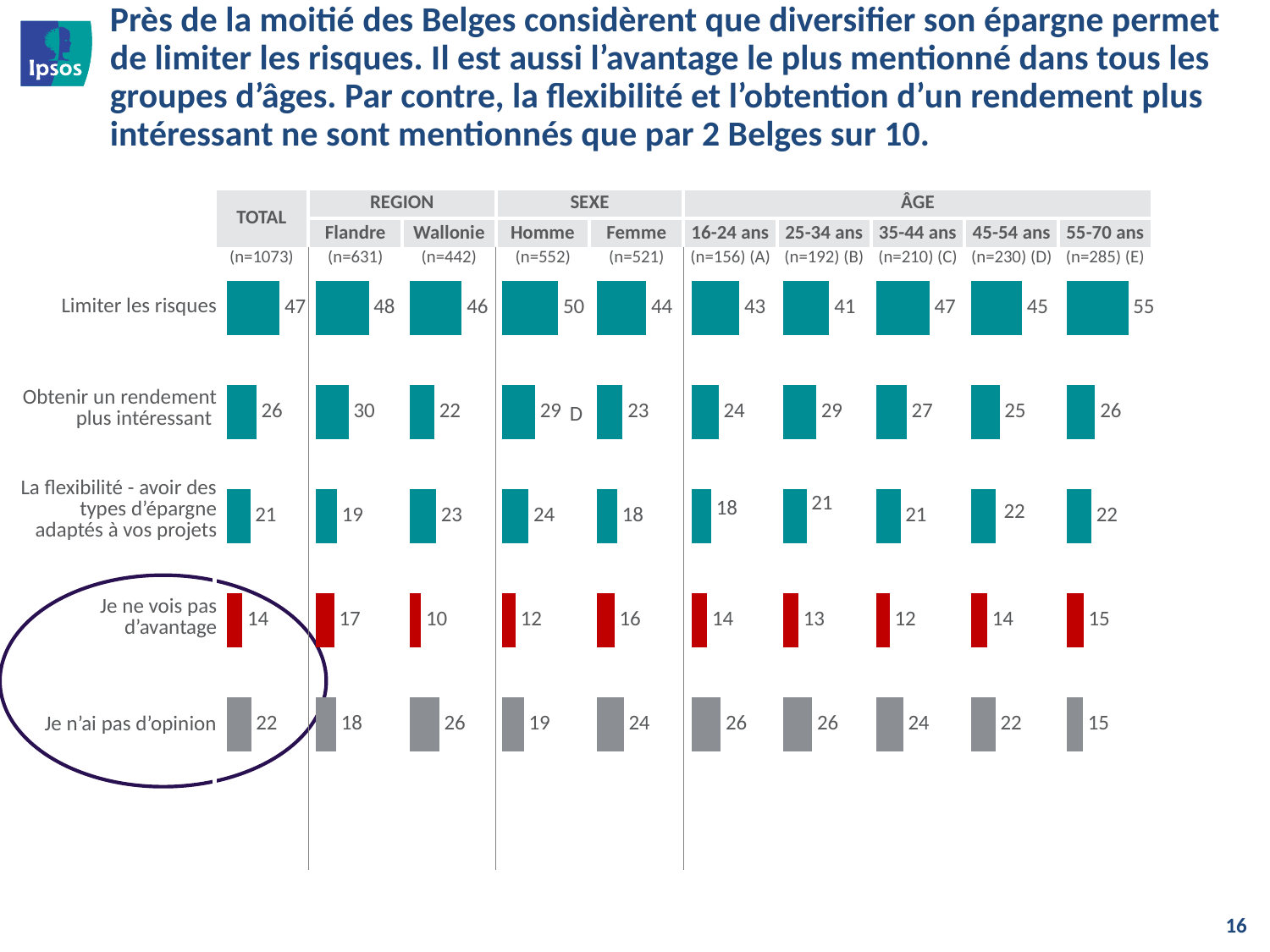
In the 55-70 ans column, what is the value for "Limiter les risques"? 55 In the Wallonie column, what is the value for "Je ne vois pas d'avantage"? 10 For "Je n'ai pas d'opinion", which is larger: the Flandre value or the Wallonie value? Wallonie How many response categories are shown as rows in the chart? 5 In the Flandre column, what is the value for "Obtenir un rendement plus intéressant"? 30 What colour are the bars for "Je ne vois pas d'avantage"? Red What is the difference between the Homme and Femme values for "Limiter les risques"? 6 What type of chart is used on this slide? Bar chart In the TOTAL column, what is the value for "Limiter les risques"? 47 In the TOTAL column, which category has the lowest value? Je ne vois pas d'avantage Across the age-group columns, which age group has the highest value for "Limiter les risques"? 55-70 ans In the TOTAL column, which category has the highest value? Limiter les risques